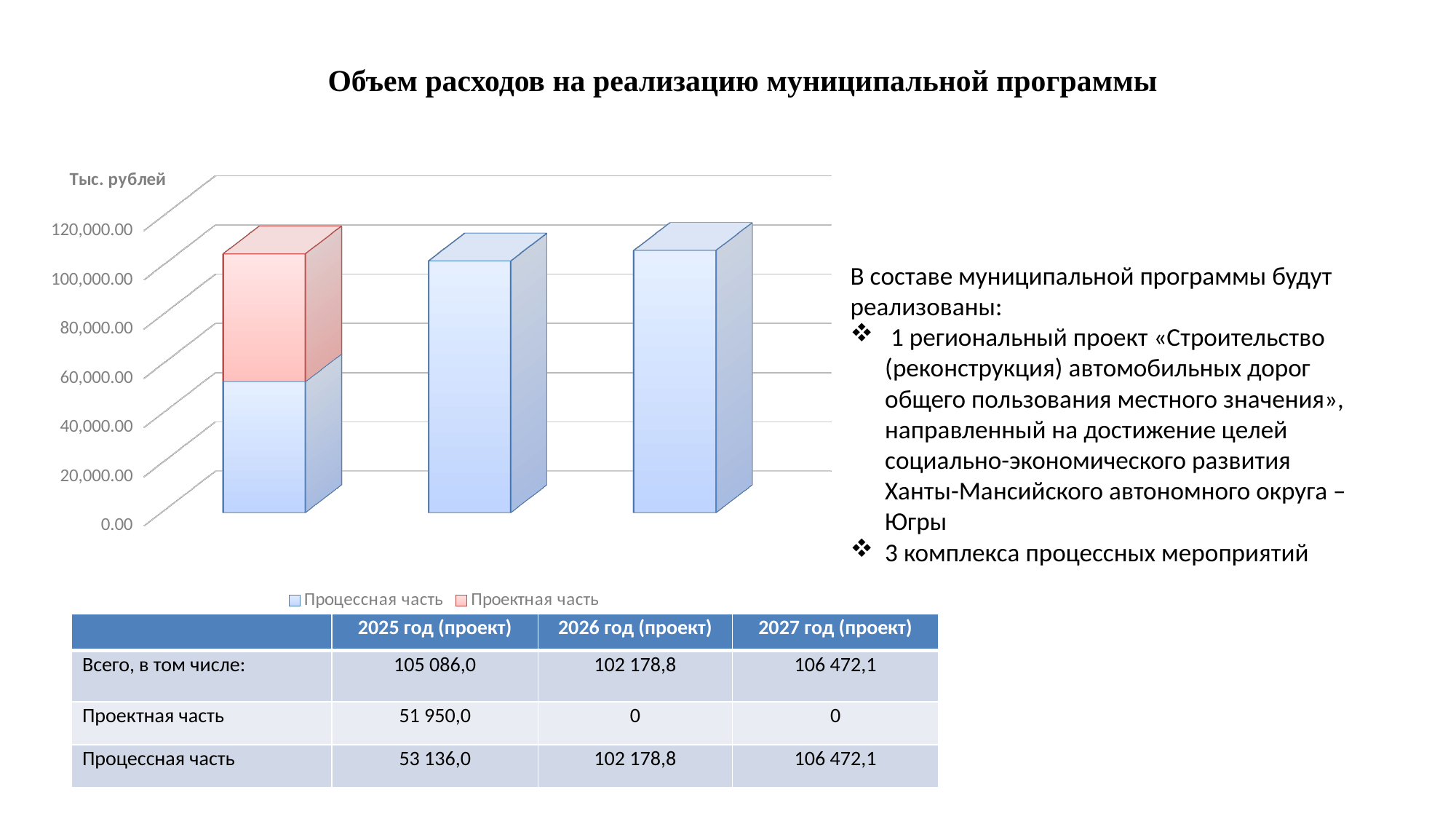
Is the total value for 2025 greater or less than 100,000.00? greater In 2025 год (проект), which is larger: Процессная часть or Проектная часть? Процессная часть What is the difference between Процессная часть and Проектная часть in 2025 год (проект)? 1 186,0 What unit is shown on the chart's vertical axis? Тыс. рублей What is the value of Проектная часть for 2025 год (проект)? 51 950,0 What kind of chart is shown on the slide? Stacked bar chart Which year has the lowest total expenditure (Всего)? 2026 год (проект) What is the total (Всего) for 2027 год (проект)? 106 472,1 Which year has the highest total expenditure (Всего)? 2027 год (проект) What is the value of Процессная часть for 2026 год (проект)? 102 178,8 How many series does the chart legend list? 2 How many bars (years) are plotted in the chart? 3